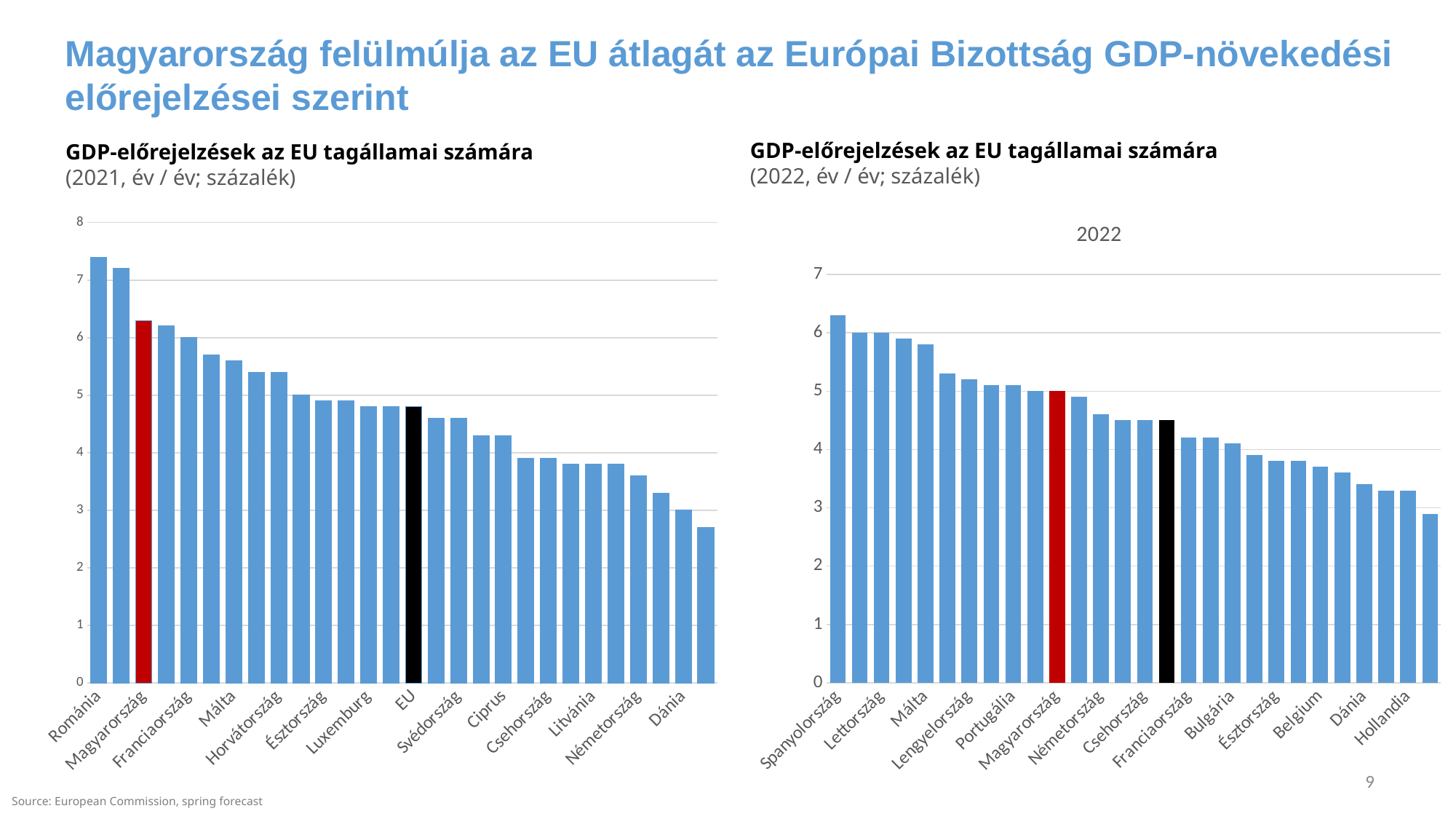
In the left chart (2021), is the value for Németország greater or less than 4? less In the right chart (2022), is the value for Spanyolország greater or less than 6? greater In the right chart (2022), which is larger, the value for Spanyolország or the value for Magyarország? Spanyolország In the left chart (2021), which is larger, the value for Magyarország or the value for EU? Magyarország In the left chart (2021), is the value for Magyarország greater or less than 6? greater What kind of chart is the left chart, 'GDP-előrejelzések az EU tagállamai számára (2021)'? bar chart In the left chart (2021), what colour is the bar for Magyarország? red In the left chart (2021), which country has the highest value? Románia In the right chart (2022), which country has the highest value? Spanyolország In the right chart (2022), do the bar values rise or fall from left to right? fall